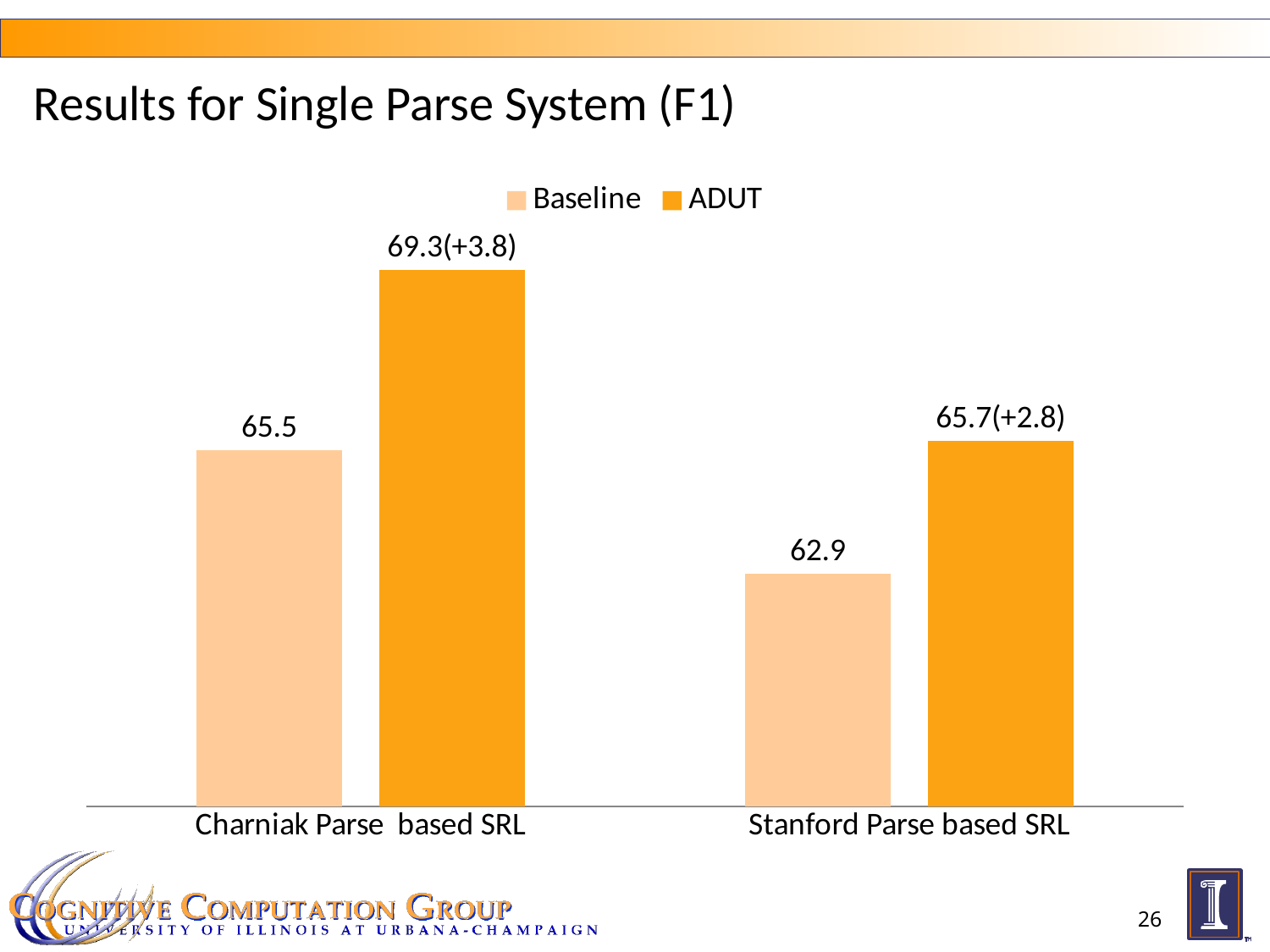
Which category has the highest ADUT value? Charniak Parse based SRL How many categories are shown on the x axis? 2 What is the difference between the Baseline values for Charniak Parse based SRL and Stanford Parse based SRL? 2.6 What is the Baseline value for Charniak Parse based SRL? 65.5 What is the Baseline value for Stanford Parse based SRL? 62.9 How many series does the legend list? 2 Which is larger for Stanford Parse based SRL, the Baseline value or the ADUT value? ADUT What is the ADUT value for Stanford Parse based SRL? 65.7 What is the ADUT value for Charniak Parse based SRL? 69.3 Which category has the lowest Baseline value? Stanford Parse based SRL What are the two series named in the legend? Baseline and ADUT What kind of chart is shown on the slide? Bar chart